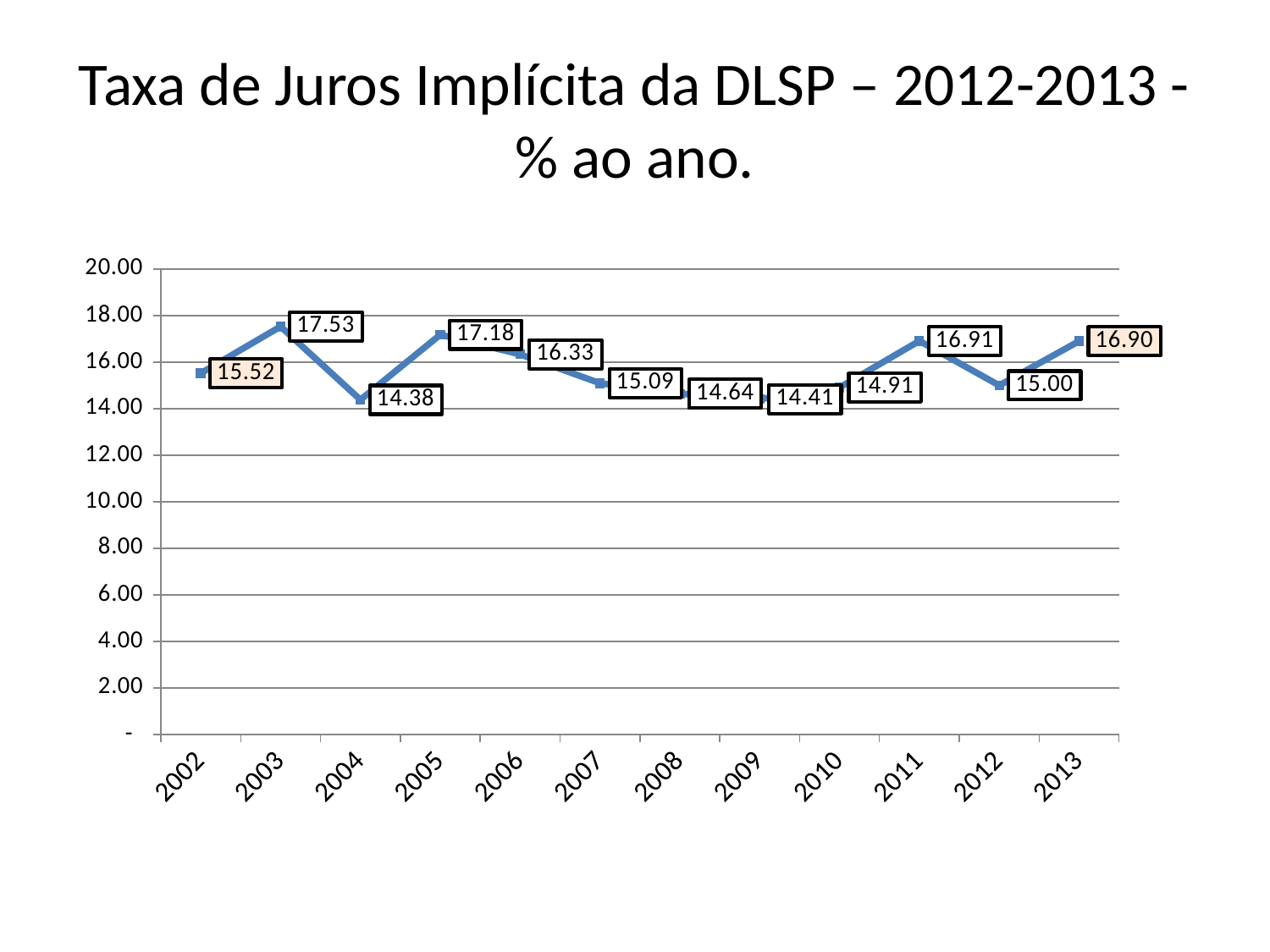
Which year has the highest value? 2003 What is the value for 2009? 14.41 What is the difference between the values for 2013 and 2012? 1.90 Is the value for 2003 greater or less than 16.00? greater What is the value for 2003? 17.53 What is the value for 2013? 16.90 How many years are plotted on the chart? 12 What kind of chart is shown on the slide? line chart What is the difference between the values for 2003 and 2004? 3.15 Which year has the lowest value? 2004 Do the values rise or fall from 2005 to 2009? fall Which is larger, the value for 2005 or the value for 2006? 2005